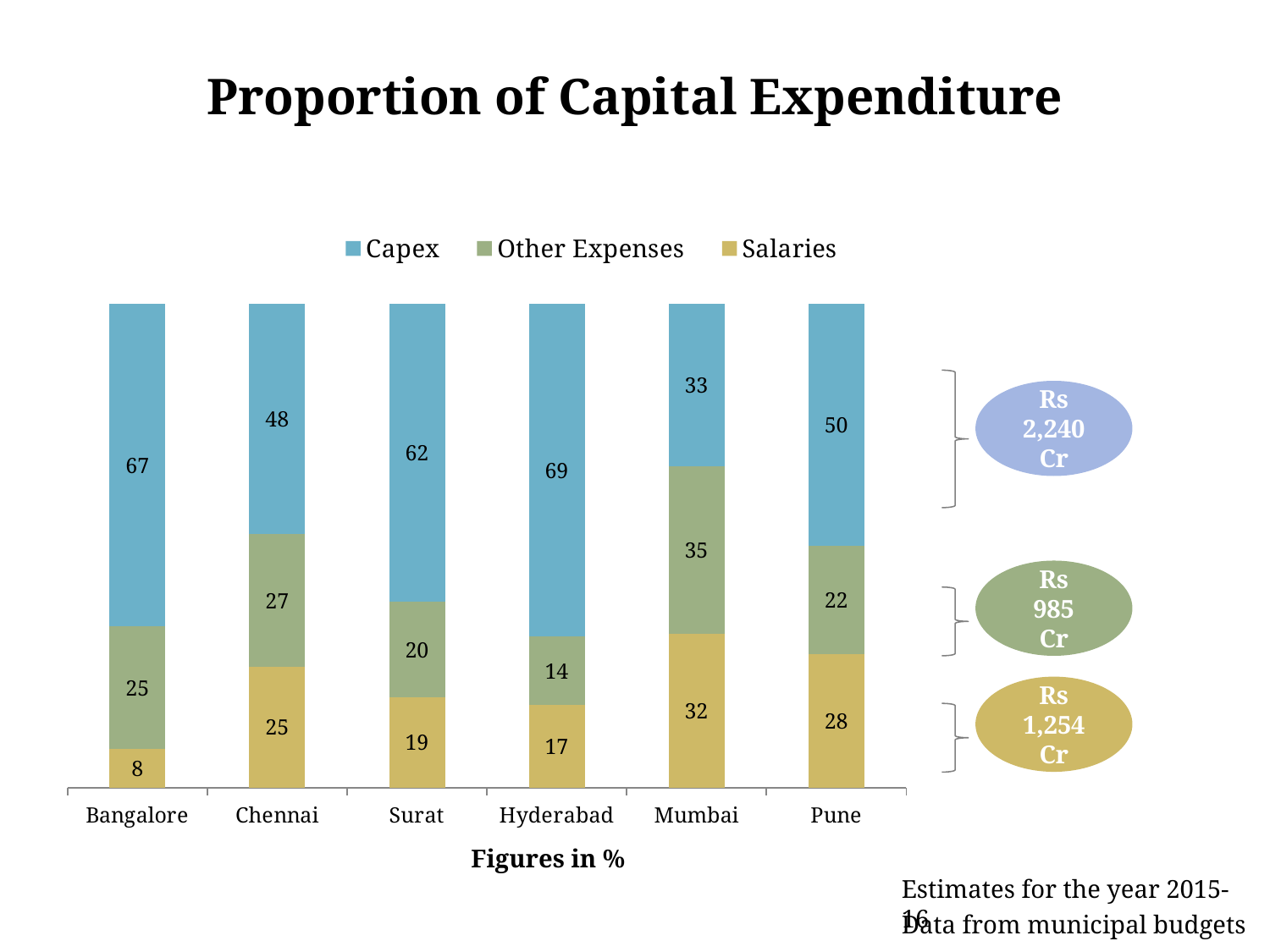
Which city has the lowest Salaries share? Bangalore What is the Salaries value for Bangalore? 8 Which city has the highest Capex share? Hyderabad Which city has the lowest Capex share? Mumbai Which is larger, the Salaries value for Pune or the Salaries value for Surat? Pune How many series does the legend list? 3 What is the Capex value for Hyderabad? 69 How many cities are shown on the x axis? 6 What kind of chart is shown on the slide? Stacked bar chart What is the difference between the Capex values for Bangalore and Chennai? 19 What is the total of the stacked bar for Mumbai? 100 What is the Other Expenses value for Mumbai? 35